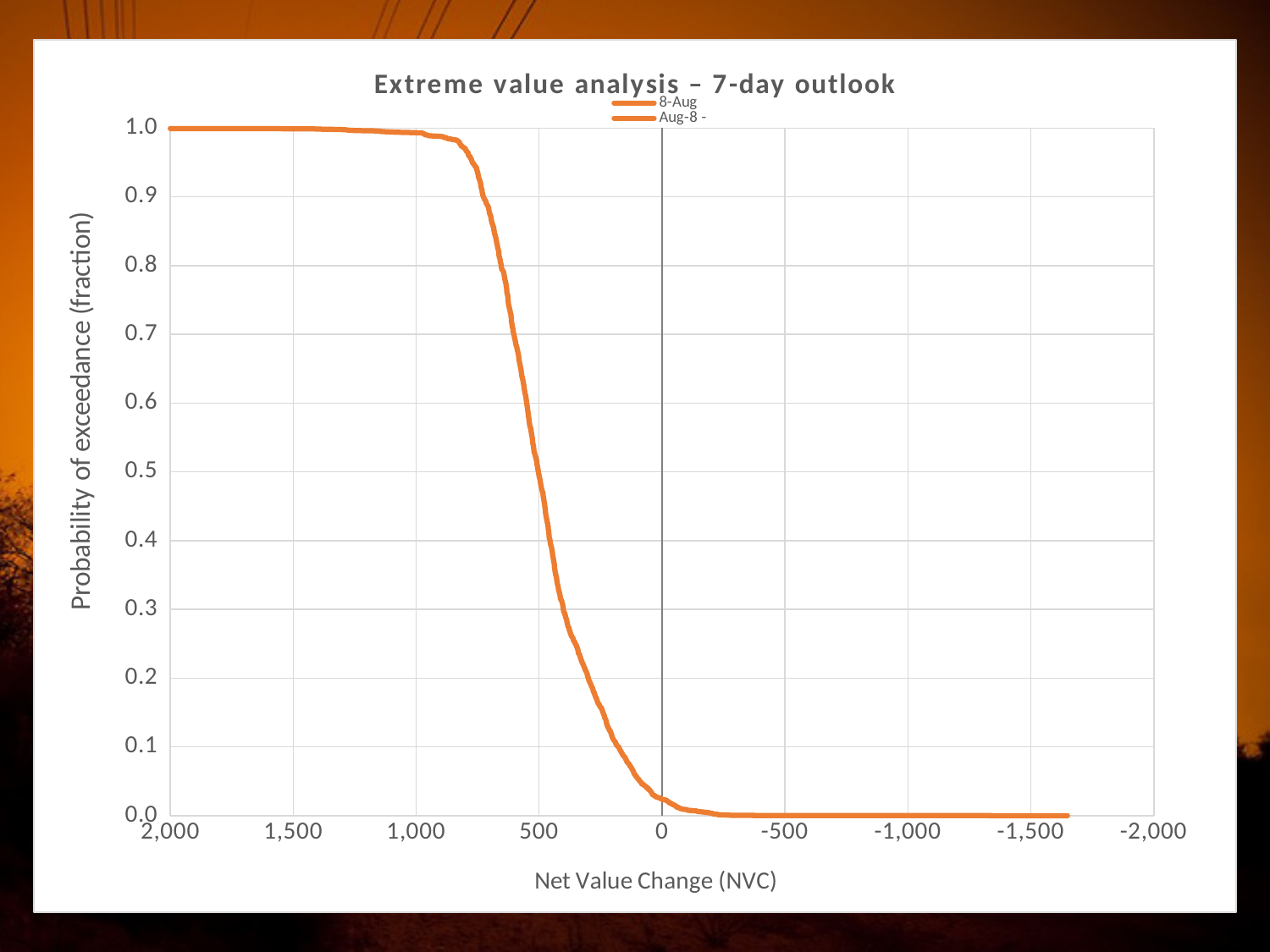
Is the probability of exceedance at a Net Value Change of 1,500 greater or less than 0.9? greater Is the probability of exceedance at a Net Value Change of 700 greater or less than 0.5? greater Is the probability of exceedance at a Net Value Change of 0 greater or less than 0.1? less What is the title of the chart? Extreme value analysis – 7-day outlook What kind of chart is shown on the slide? Line chart Moving from left to right along the x axis, does the probability of exceedance rise or fall? Fall What is the label of the vertical axis? Probability of exceedance (fraction) Which is larger: the probability of exceedance at a Net Value Change of 1,000 or at a Net Value Change of 0? At 1,000 How many series does the legend list? 2